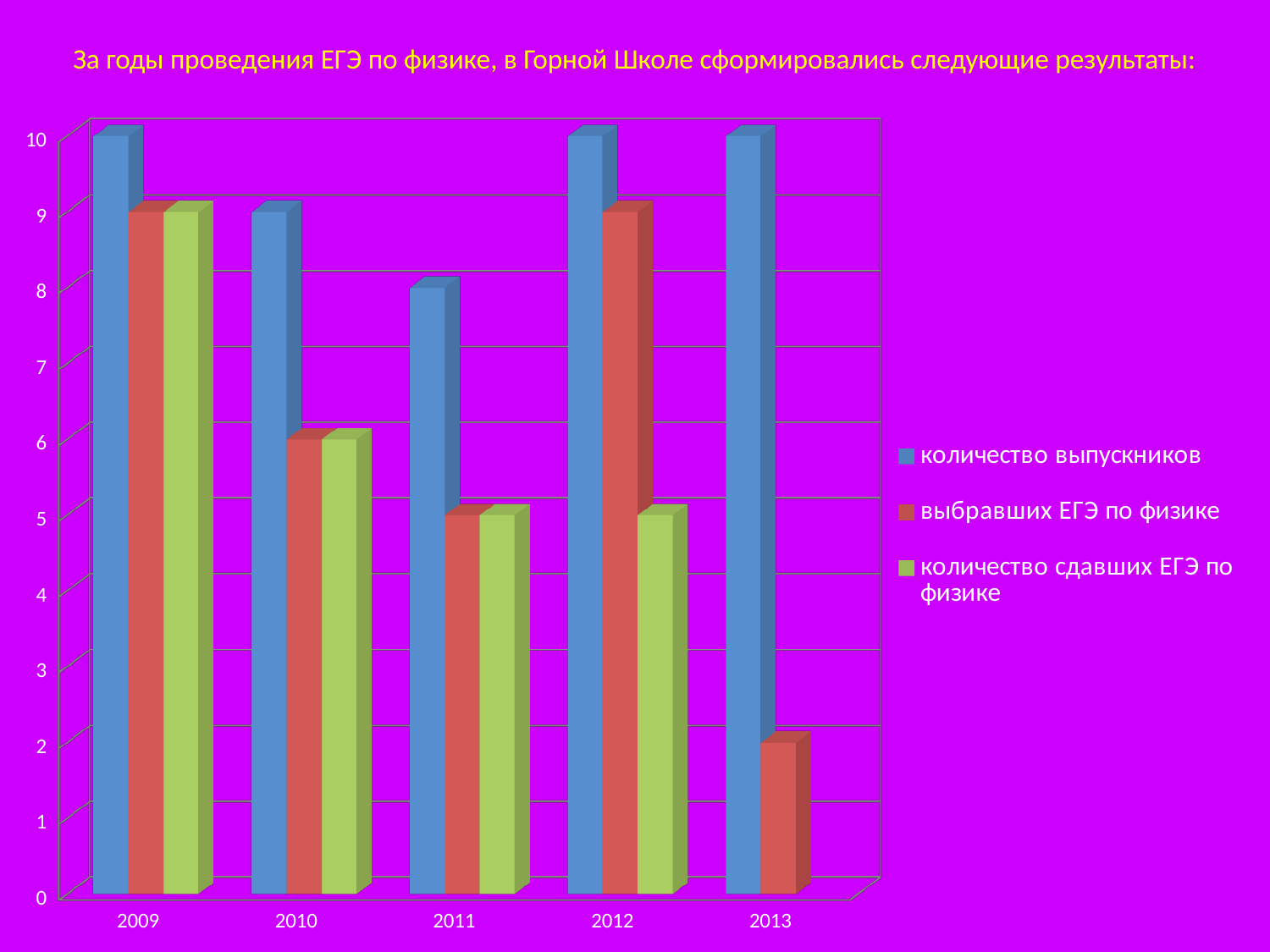
What is the value of 'количество выпускников' for 2011? 8 Which colour represents 'количество сдавших ЕГЭ по физике' in the legend? green In which year is 'количество выпускников' lowest? 2011 In which year is 'выбравших ЕГЭ по физике' lowest? 2013 Which is larger in 2012: 'выбравших ЕГЭ по физике' or 'количество сдавших ЕГЭ по физике'? выбравших ЕГЭ по физике What is the value of 'количество сдавших ЕГЭ по физике' for 2010? 6 Is the value of 'выбравших ЕГЭ по физике' for 2010 greater or less than 8? less How many years are shown on the x axis? 5 What is the difference between 'количество выпускников' and 'выбравших ЕГЭ по физике' in 2013? 8 What is the value of 'выбравших ЕГЭ по физике' for 2013? 2 What kind of chart is shown on the slide? bar chart How many series does the legend list? 3